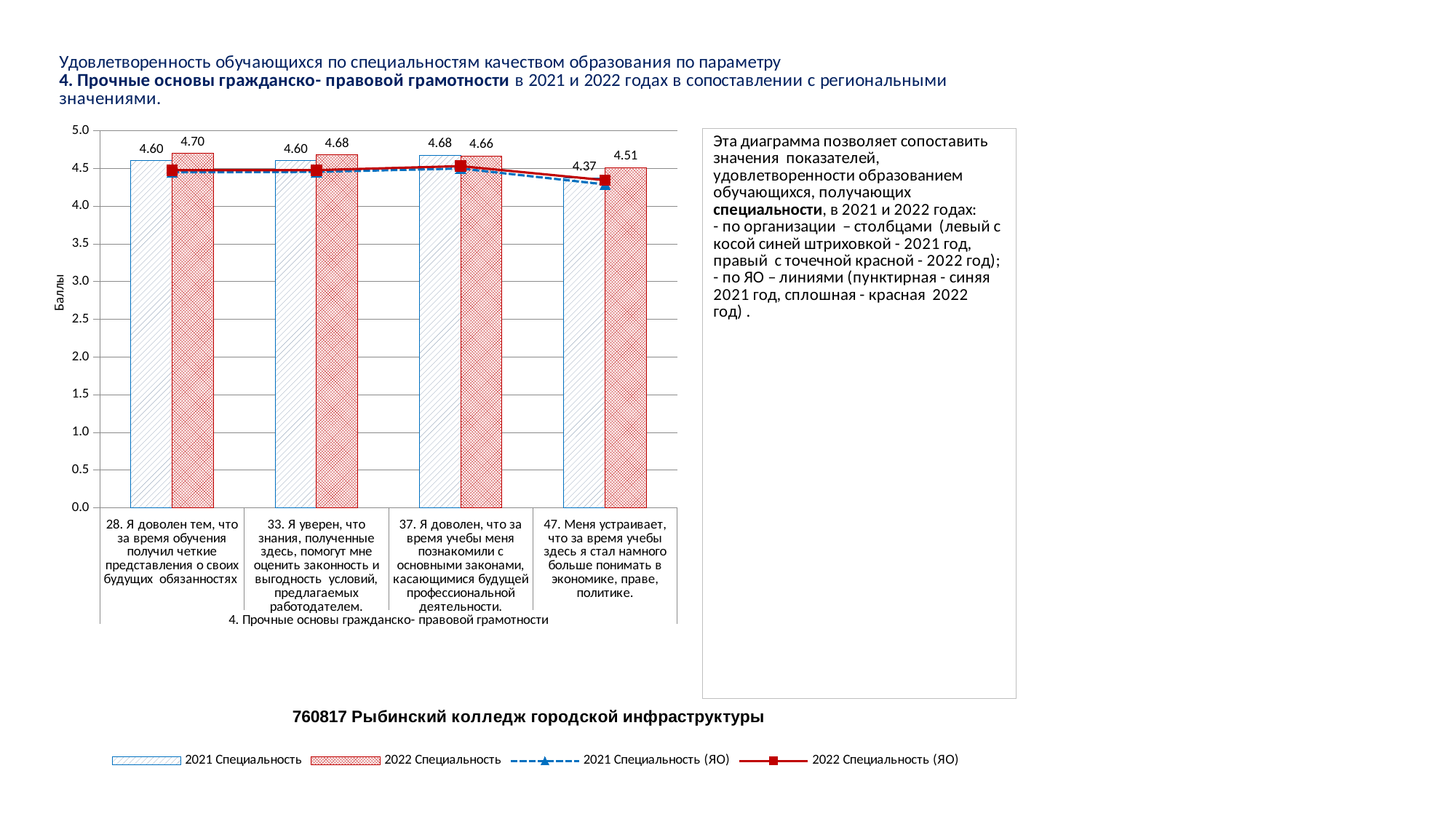
What is the value of the 2022 Специальность bar for question 28 (Я доволен тем, что за время обучения получил четкие представления о своих будущих обязанностях)? 4.70 What is the value of the 2021 Специальность bar for question 37 (Я доволен, что за время учебы меня познакомили с основными законами)? 4.68 What type of chart is shown on the slide? Combined bar and line chart What is the difference between the 2022 and 2021 Специальность bars for question 47? 0.14 Which question has the lowest 2021 Специальность bar? 47. Меня устраивает, что за время учебы здесь я стал намного больше понимать в экономике, праве, политике. How many series does the legend list? 4 How many survey questions (categories) are shown on the x axis? 4 What is the label of the vertical axis? Баллы Which question has the highest 2022 Специальность bar? 28. Я доволен тем, что за время обучения получил четкие представления о своих будущих обязанностях Is the 2021 Специальность (ЯО) line value for question 47 greater or less than 4.5? less For question 37, which bar is larger: 2021 Специальность or 2022 Специальность? 2021 Специальность What is the value of the 2021 Специальность bar for question 47 (Меня устраивает, что за время учебы здесь я стал намного больше понимать в экономике, праве, политике)? 4.37